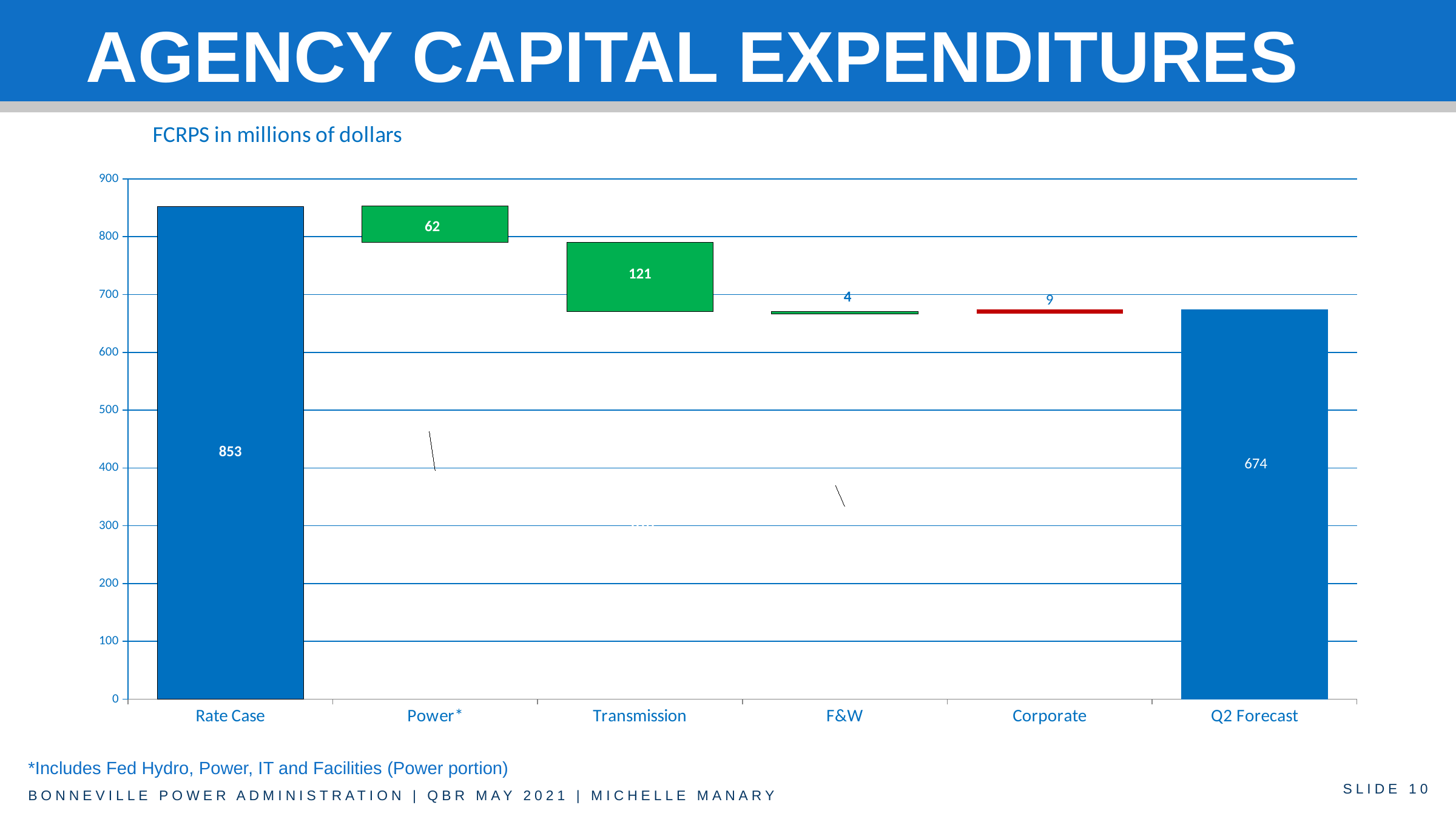
What is the difference between the Rate Case value and the Q2 Forecast value? 179 Which is larger, the value for Power* or the value for Transmission? Transmission What is the value shown for Power*? 62 Which category has the highest value? Rate Case What is the value for Rate Case? 853 What is the value shown for Transmission? 121 How many categories are shown on the x axis? 6 What is the value for Q2 Forecast? 674 Is the value for Q2 Forecast greater or less than 700? less What is the value shown for Corporate? 9 What is the title of the chart? FCRPS in millions of dollars Which category has the lowest value? F&W